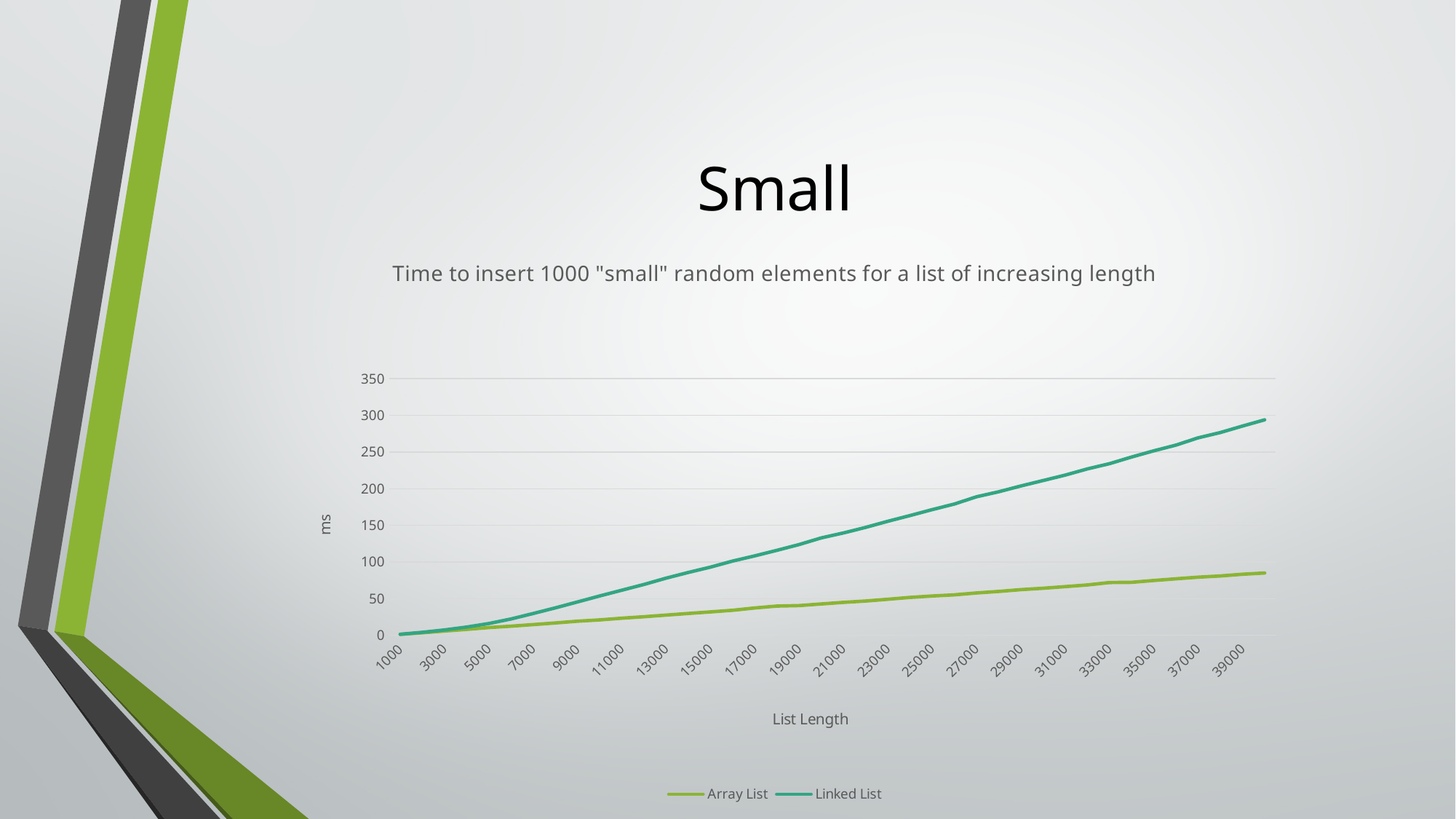
How many list length labels are shown on the x axis? 20 How many series does the legend list? 2 What is the title of the chart? Time to insert 1000 "small" random elements for a list of increasing length At list length 39000, which series has the larger value, Array List or Linked List? Linked List What kind of chart is shown on the slide? line chart Is the value for Array List at list length 11000 greater or less than 50? less Is the value for Linked List at list length 31000 greater or less than 200? greater Is the value for Linked List at list length 39000 greater or less than 250? greater Does the Linked List series rise or fall as list length increases? rise What is the label of the x axis? List Length